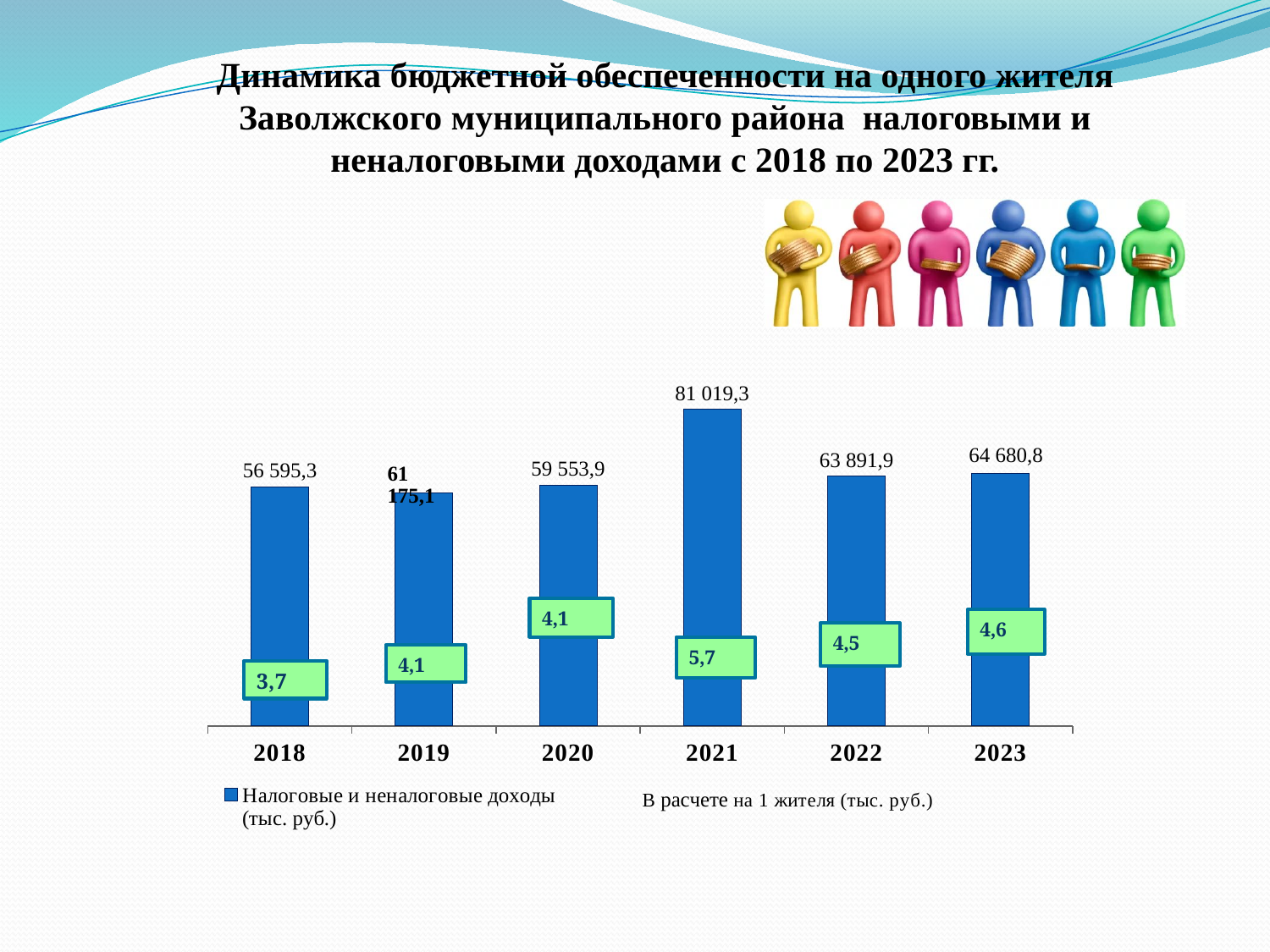
What is the value of tax and non-tax revenues for 2021? 81 019,3 What kind of chart is shown on the slide? Bar chart What is the per-resident value (В расчете на 1 жителя) shown for 2022? 4,5 What is the per-resident value shown for 2018? 3,7 What is the difference between the tax and non-tax revenues for 2021 and 2018? 24 424,0 What is the difference between the per-resident values for 2021 and 2018? 2,0 How many years are shown on the x axis of the chart? 6 Do the tax and non-tax revenues rise or fall from 2021 to 2022? Fall Which year has the lowest tax and non-tax revenues? 2018 Which year has the highest tax and non-tax revenues? 2021 What is the value of tax and non-tax revenues (Налоговые и неналоговые доходы) for 2018? 56 595,3 Which year has higher tax and non-tax revenues, 2019 or 2020? 2019